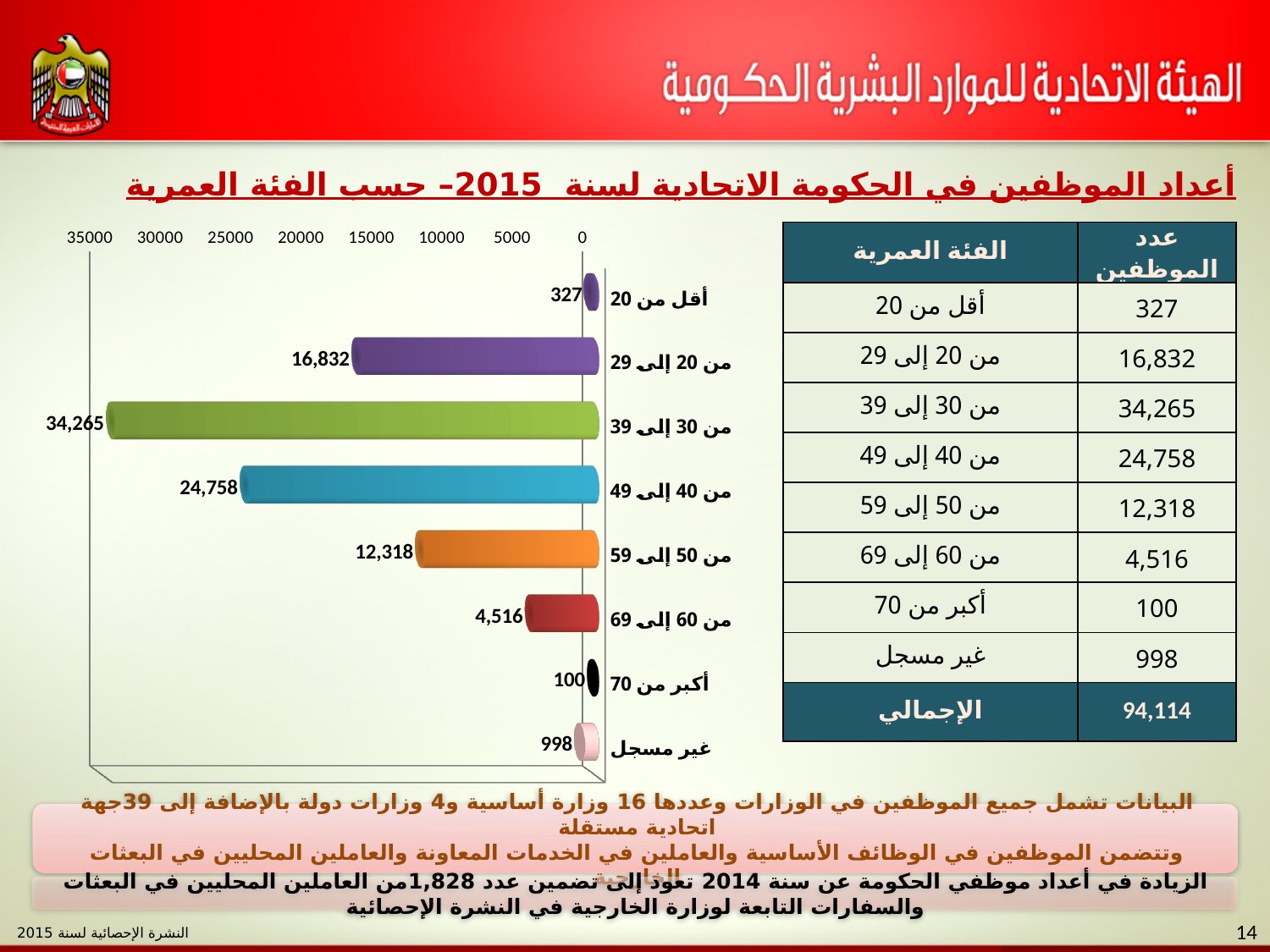
What is the difference between the values for "من 30 إلى 39" and "من 40 إلى 49"? 9,507 What kind of chart is shown on the slide? bar chart How many categories are plotted in the bar chart? 8 What value is shown for the age group "من 30 إلى 39" in the bar chart? 34,265 What is the maximum value shown on the chart's axis? 35000 What is the difference between the values for "أقل من 20" and "أكبر من 70"? 227 What value is shown for the category "غير مسجل" in the bar chart? 998 Which is larger, the value for "من 50 إلى 59" or the value for "من 60 إلى 69"? من 50 إلى 59 Is the value for "من 40 إلى 49" greater or less than 20000? greater What value is shown for the age group "من 20 إلى 29" in the bar chart? 16,832 Which age group has the highest value in the bar chart? من 30 إلى 39 Which category has the lowest value in the bar chart? أكبر من 70